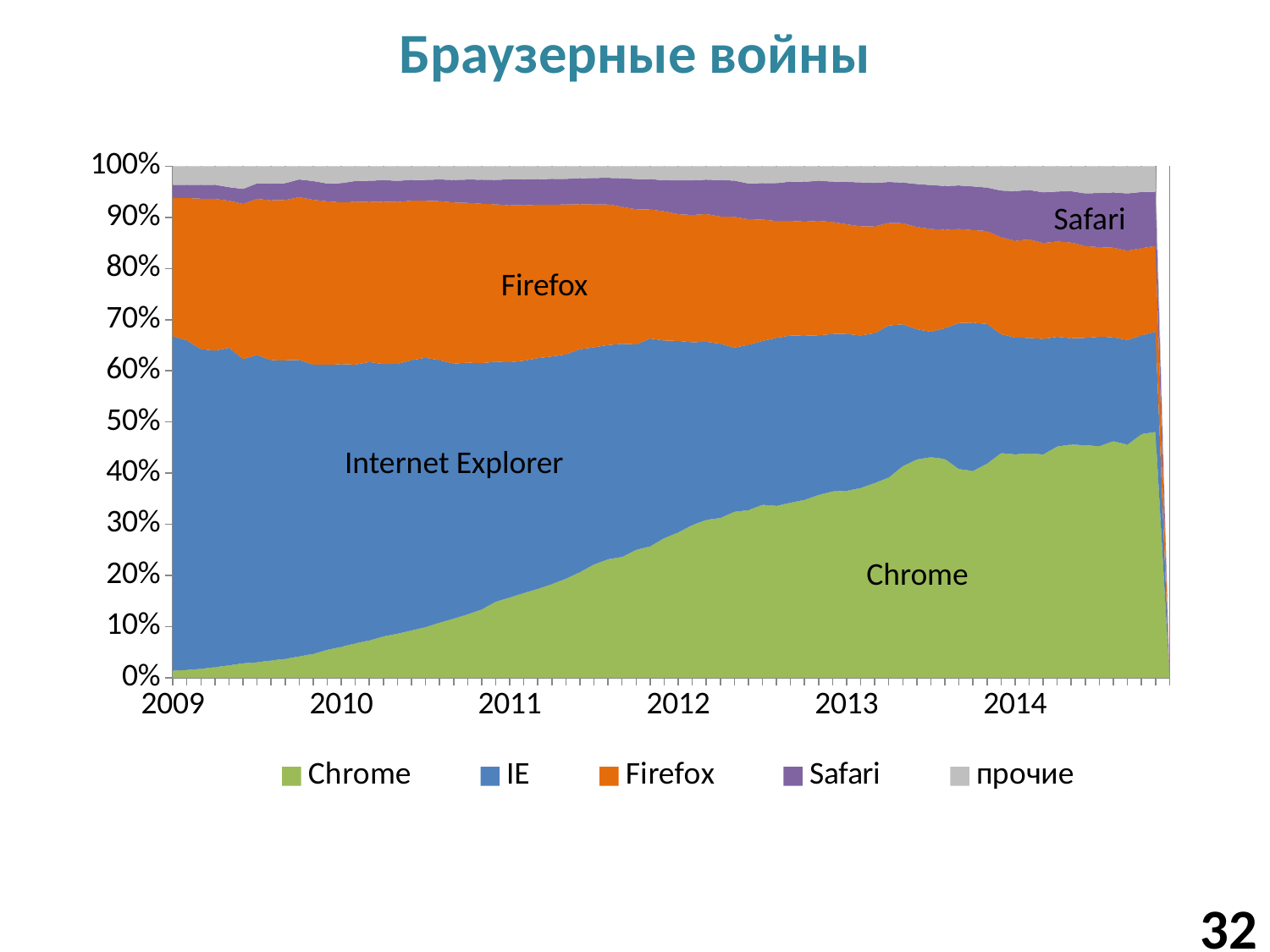
What is the title of the chart? Браузерные войны Which series is plotted at the bottom of the stacked area chart? Chrome Which series has a larger share at the start of 2014, Chrome or Safari? Chrome Is the Chrome share at the start of 2012 greater or less than 30%? less Which series has a larger share at the start of 2009, Chrome or IE? IE Is the Chrome share at the start of 2014 greater or less than 40%? greater Which year labels appear on the x axis? 2009, 2010, 2011, 2012, 2013, 2014 Is the Chrome share at the start of 2009 greater or less than 10%? less Does the Chrome share rise or fall from 2009 to 2014? rise Does the Internet Explorer share rise or fall from 2009 to 2014? fall How many series does the legend list? 5 What kind of chart is shown on the slide? stacked area chart